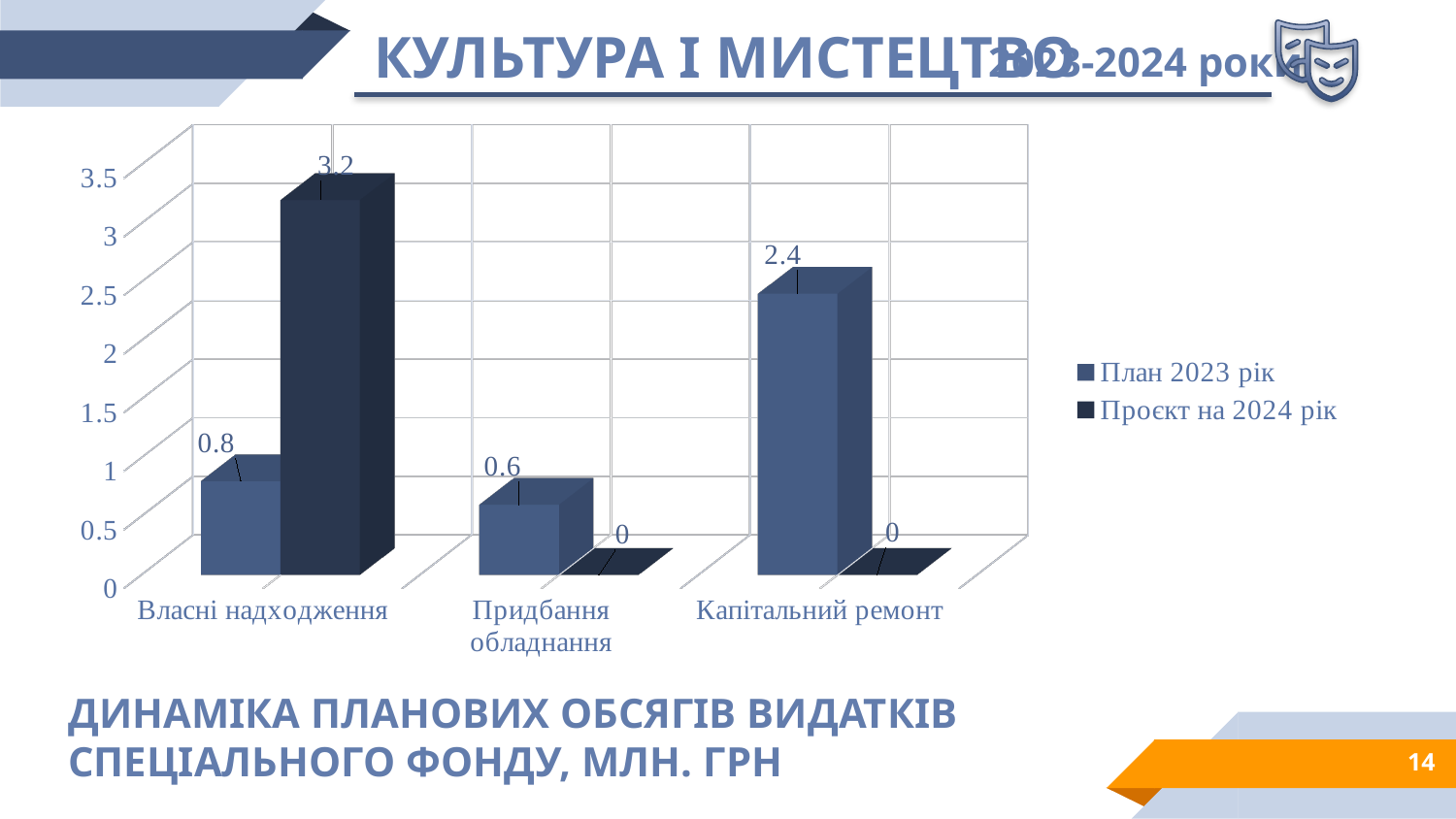
How many categories are shown on the x axis? 3 What is the value for Капітальний ремонт in the План 2023 рік series? 2.4 How many series does the legend list? 2 What is the value for Придбання обладнання in the Проєкт на 2024 рік series? 0 What kind of chart is shown on the slide? Bar chart Which category has the lowest value in the План 2023 рік series? Придбання обладнання What is the value for Власні надходження in the План 2023 рік series? 0.8 What are the two series names listed in the legend? План 2023 рік and Проєкт на 2024 рік Which category has the highest value in the План 2023 рік series? Капітальний ремонт What is the difference between the Проєкт на 2024 рік and План 2023 рік values for Власні надходження? 2.4 Which is larger for Капітальний ремонт: the План 2023 рік value or the Проєкт на 2024 рік value? План 2023 рік What is the value for Власні надходження in the Проєкт на 2024 рік series? 3.2